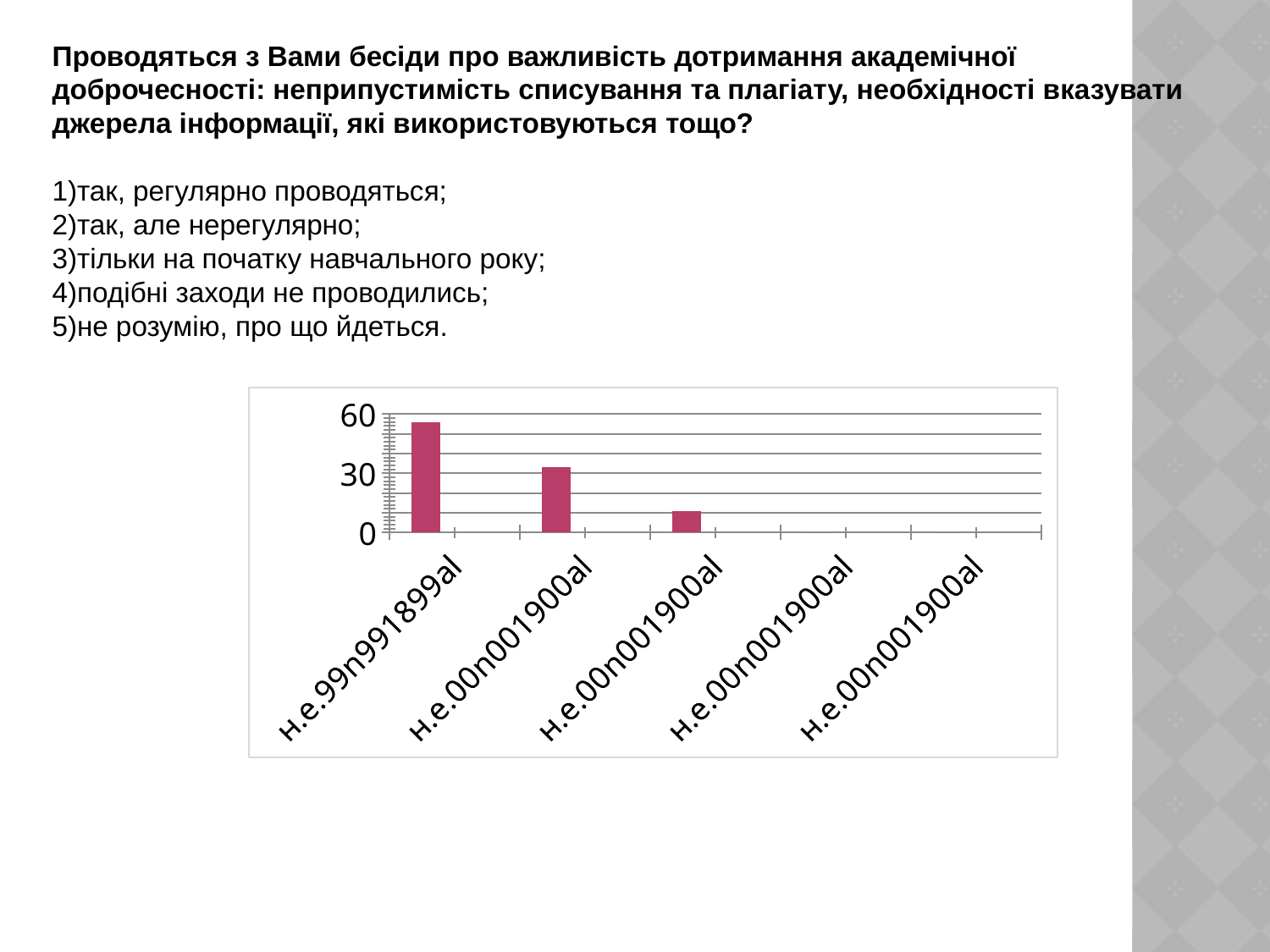
Is the value of the first (leftmost) bar greater or less than 60? less What is the highest value labelled on the vertical axis of the chart? 60 Which is larger, the second bar or the third bar? the second bar What colour are the bars in the chart? pink (magenta) How many categories are shown along the x axis of the chart? 5 Is the value of the first (leftmost) bar greater or less than 30? greater Which is larger, the first bar or the second bar? the first bar Which bar in the chart is the tallest? the first (leftmost) bar Do the bar values rise or fall from left to right along the x axis? fall Is the value of the third bar greater or less than 30? less What kind of chart is shown on the slide? bar chart